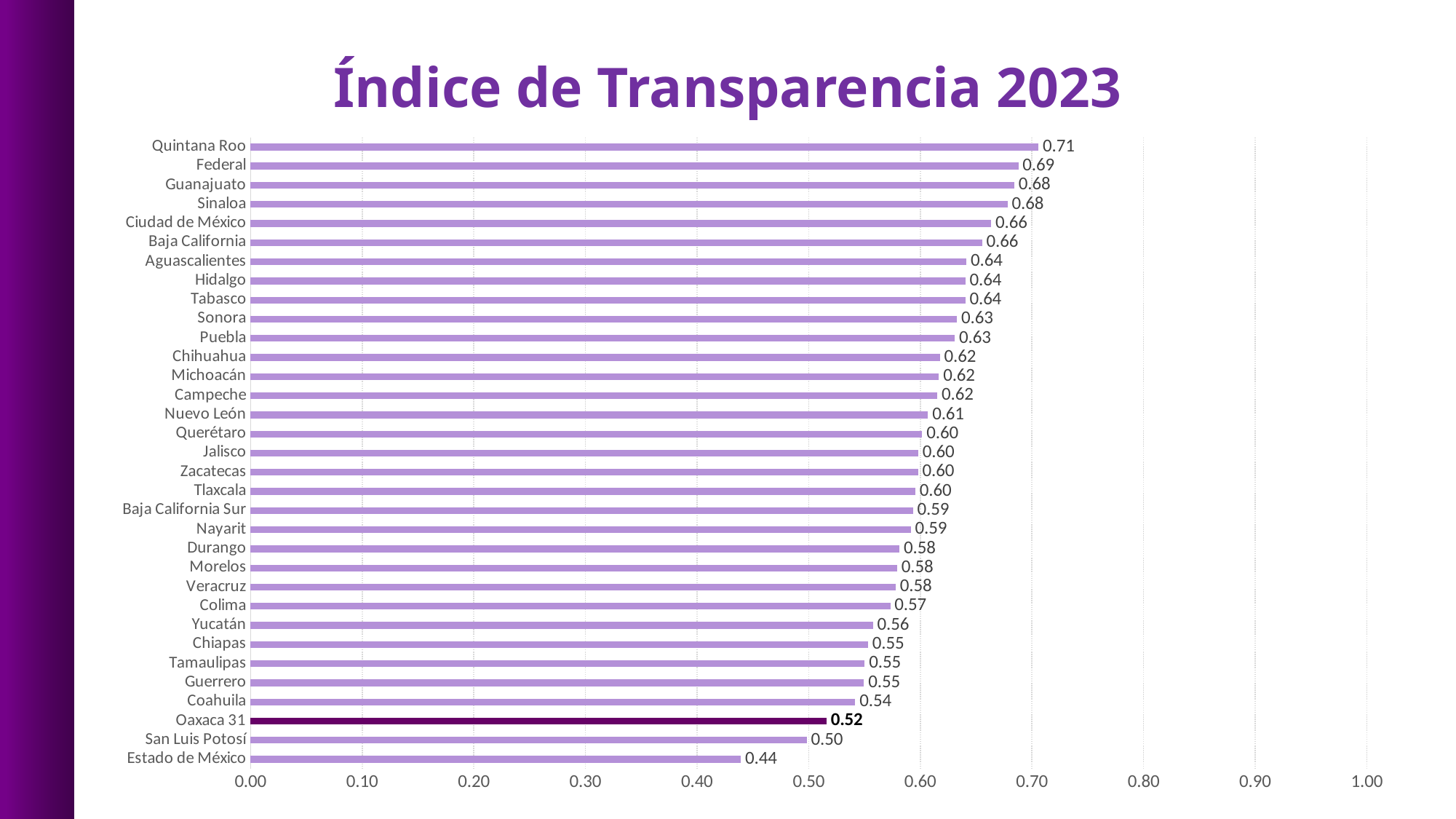
What is the value for Oaxaca 31? 0.52 What is the value for Quintana Roo? 0.71 What is the title of the chart? Índice de Transparencia 2023 How many categories are shown in the chart? 33 What is the difference between the values for Quintana Roo and Estado de México? 0.27 What is the value for Estado de México? 0.44 Which category has the lowest value? Estado de México Is the value for Sonora greater or less than 0.50? greater Which has a larger value, Federal or Coahuila? Federal Which category has the highest value? Quintana Roo What kind of chart is shown on the slide? Bar chart What is the value for Nuevo León? 0.61